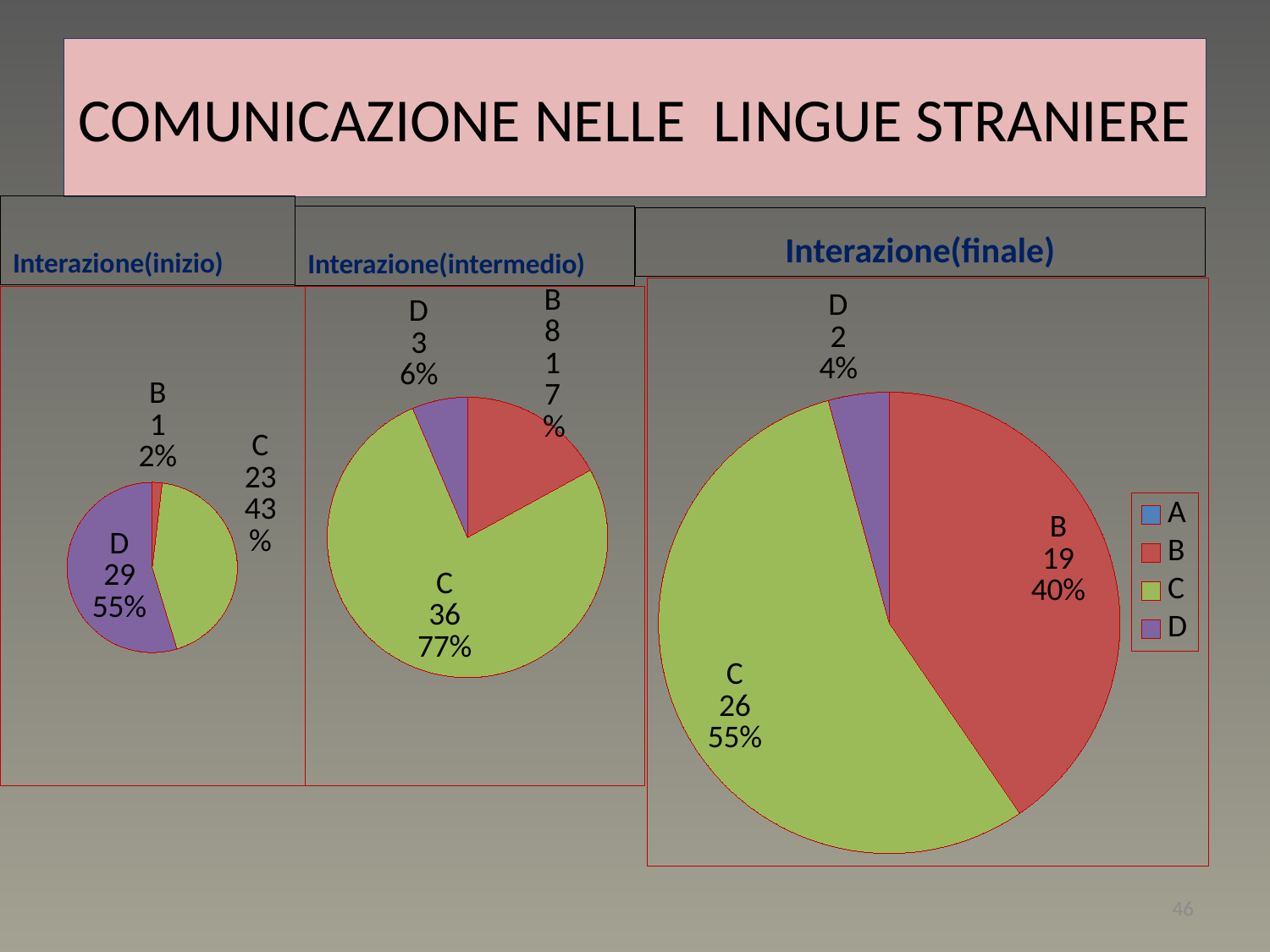
What kind of chart is the Interazione(finale) chart? pie chart In the Interazione(intermedio) chart, what is the difference between the values for C and B? 28 In the Interazione(intermedio) chart, which category has the largest slice? C How many entries does the legend of the Interazione(finale) chart list? 4 In the Interazione(inizio) chart, what share of the pie does C have? 43% In the Interazione(intermedio) chart, what is the value for C? 36 In the Interazione(finale) chart, which is larger, the value for B or the value for C? C In the Interazione(finale) chart, what share of the pie does C have? 55% In the Interazione(finale) chart, what is the value for B? 19 In the Interazione(inizio) chart, what is the value for D? 29 In the Interazione(inizio) chart, which category has the smallest slice? B In the Interazione(intermedio) chart, what share of the pie does D have? 6%